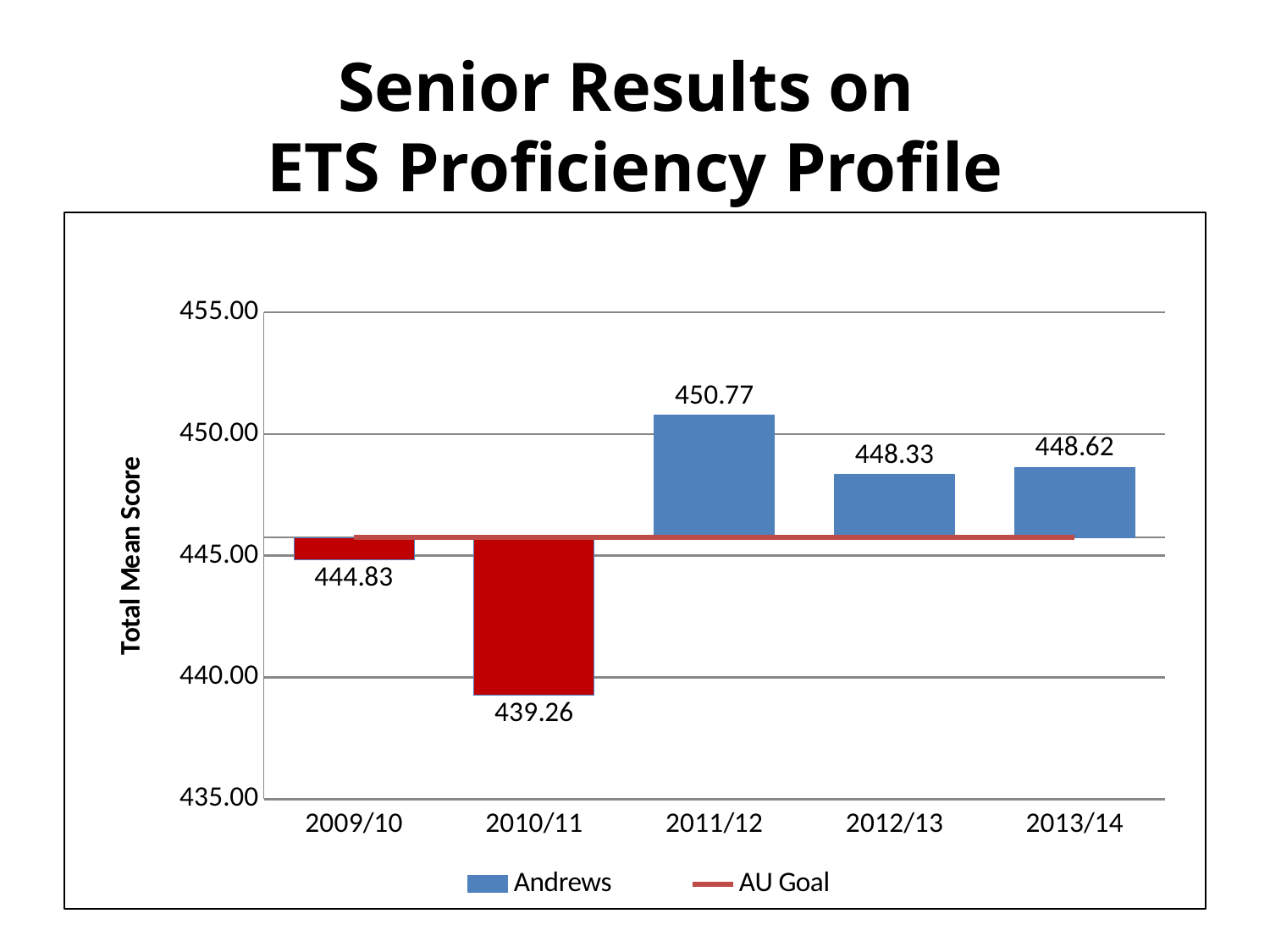
What is the Andrews value for 2010/11? 439.26 What is the Andrews value for 2011/12? 450.77 Is the AU Goal line greater or less than 450.00? less What is the difference between the Andrews scores for 2011/12 and 2010/11? 11.51 What is the difference between the Andrews scores for 2013/14 and 2012/13? 0.29 How many years are shown on the x axis? 5 How many series does the legend list? 2 What is the Andrews value for 2009/10? 444.83 What is the title of the y axis? Total Mean Score Which is larger, the Andrews score for 2009/10 or for 2012/13? 2012/13 Which year has the lowest Andrews score? 2010/11 Which year has the highest Andrews score? 2011/12